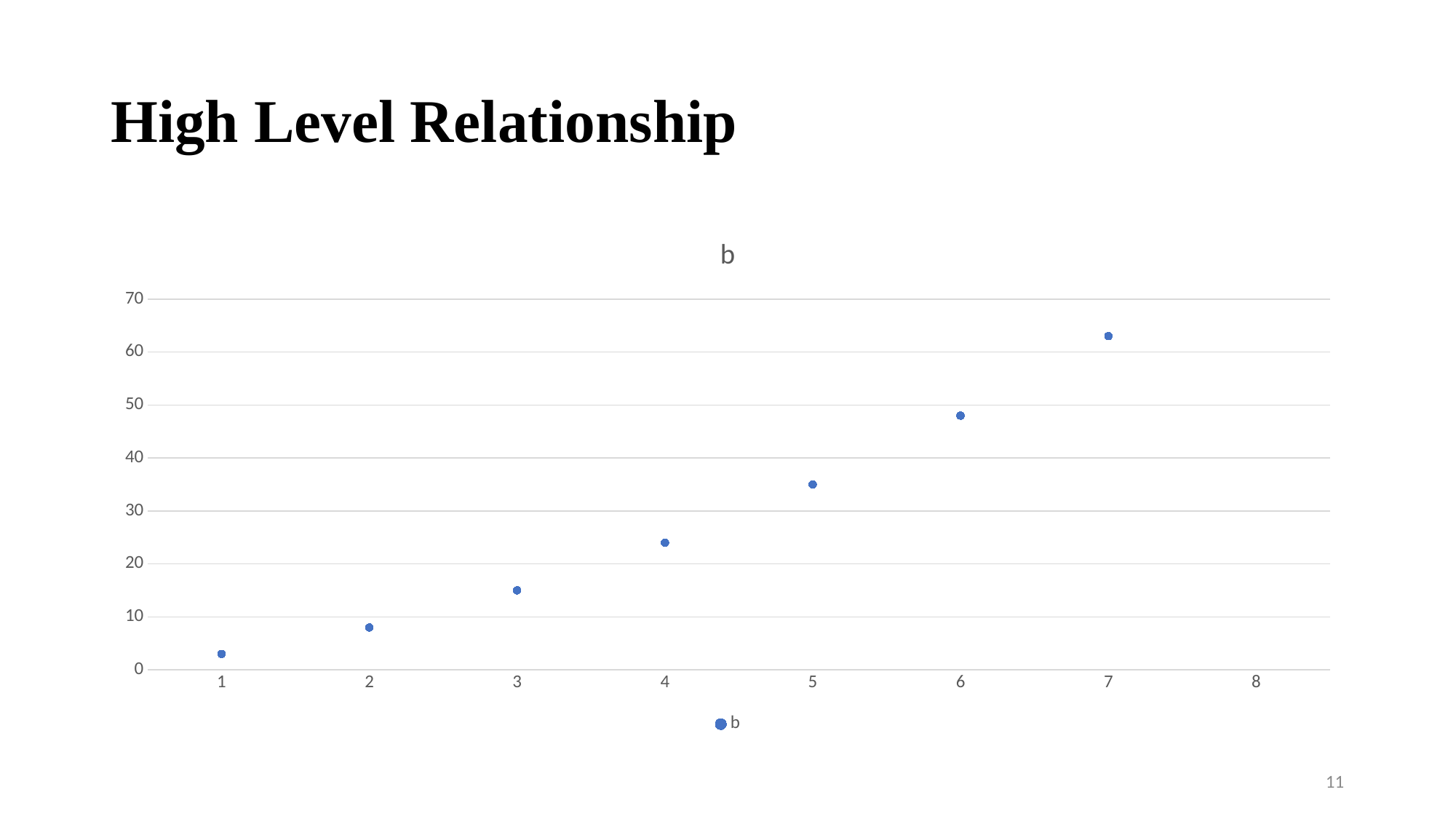
At which x value is the plotted value highest? 7 Is the value at x = 1 greater or less than 10? less How many series does the legend list? 1 At which x value is the plotted value lowest? 1 How many data points are plotted on the chart? 7 Do the values rise or fall as x increases from 1 to 7? rise Is the value at x = 4 greater or less than 20? greater Is the value at x = 6 greater or less than 50? less What kind of chart is shown on the slide? scatter chart Which has the larger value, the point at x = 6 or the point at x = 4? x = 6 What is the title of the chart? b